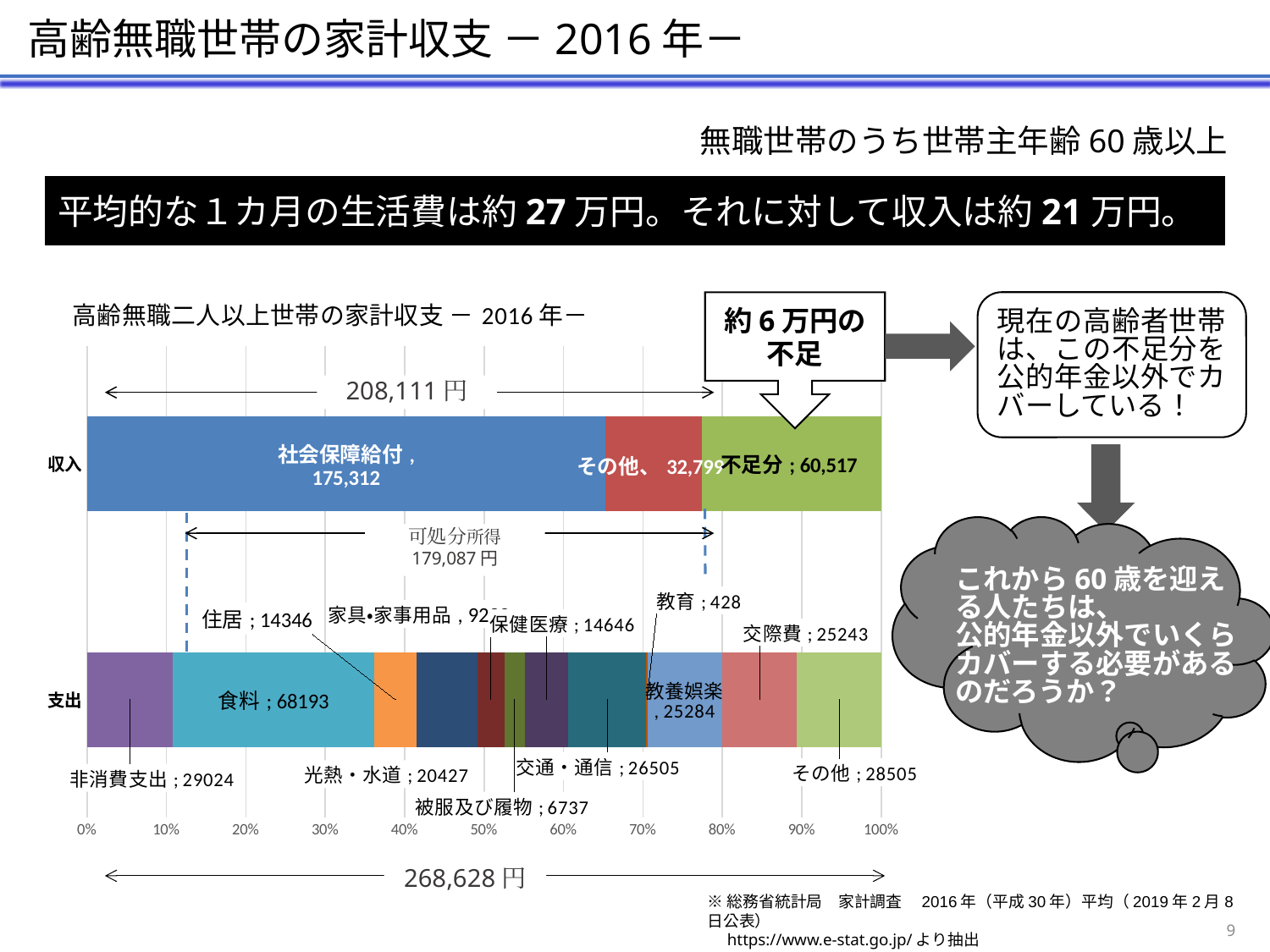
What is the value of 食料 in the 支出 bar? 68193 What is the value of 教育 in the 支出 bar? 428 Which category in the 支出 bar has the smallest value? 教育 Which category in the 支出 bar has the largest value? 食料 What is the value of 不足分 in the 収入 bar? 60,517 What is the total of the 支出 bar as labelled on the slide? 268,628 円 What is the value of 社会保障給付 in the 収入 bar? 175,312 Is the share of 社会保障給付 in the 収入 bar greater or less than 60%? greater What is the title of the chart? 高齢無職二人以上世帯の家計収支 － 2016 年－ Which is larger in the 支出 bar, 交際費 or 住居? 交際費 What kind of chart is shown on the slide? Stacked bar chart What is the difference between 食料 and 非消費支出 in the 支出 bar? 39169